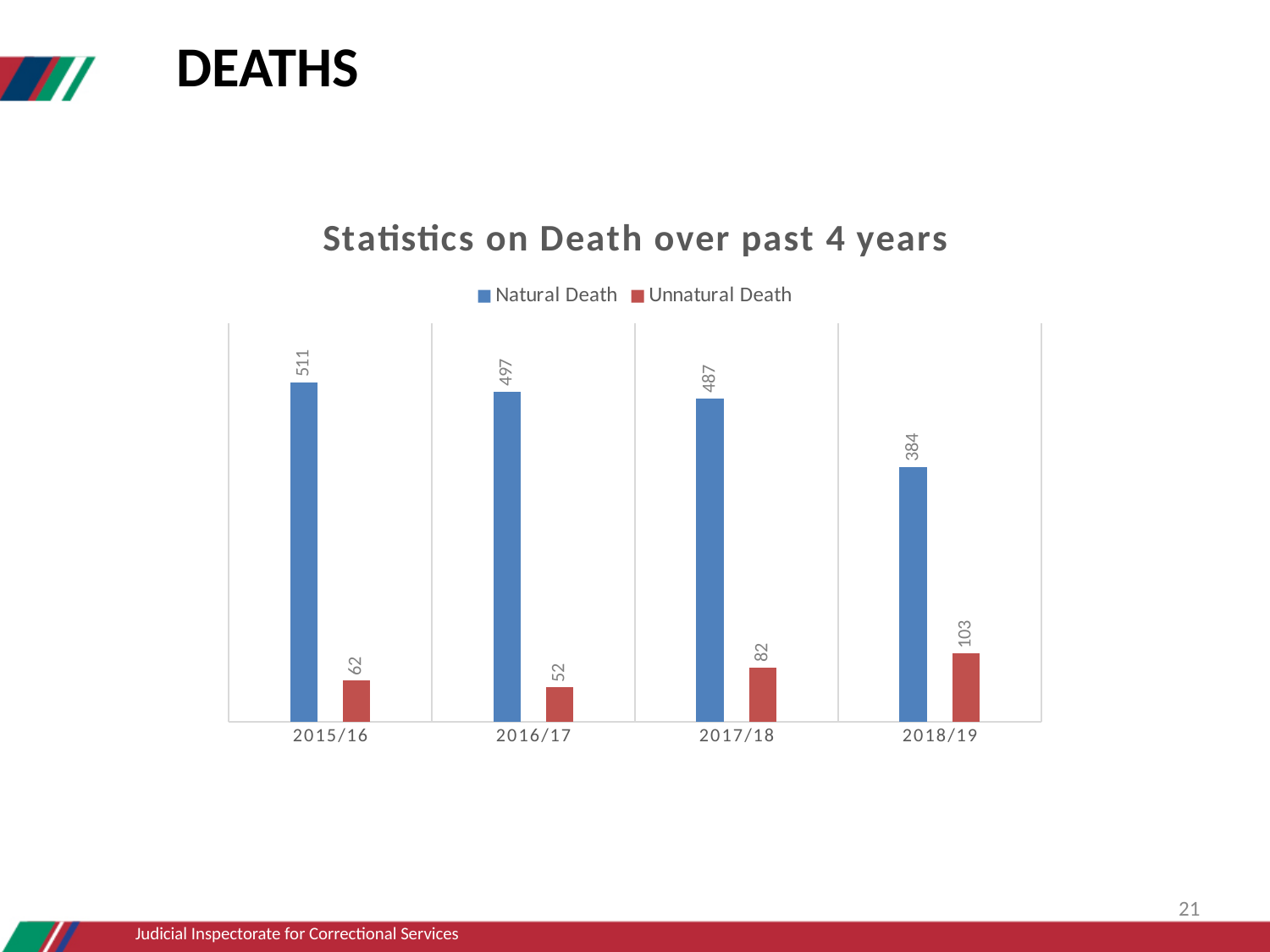
Do the Natural Death values rise or fall from 2015/16 to 2018/19? Fall What is the value for Unnatural Death in 2018/19? 103 How many years are shown on the x axis? 4 Which year has the highest Natural Death value? 2015/16 What is the value for Natural Death in 2015/16? 511 What is the value for Unnatural Death in 2016/17? 52 What is the difference between Natural Death and Unnatural Death in 2017/18? 405 Which year has the lowest Unnatural Death value? 2016/17 What is the title of the chart? Statistics on Death over past 4 years How many series does the legend list? 2 Which is larger: Unnatural Death in 2015/16 or Unnatural Death in 2017/18? Unnatural Death in 2017/18 What kind of chart is shown on the slide? Bar chart